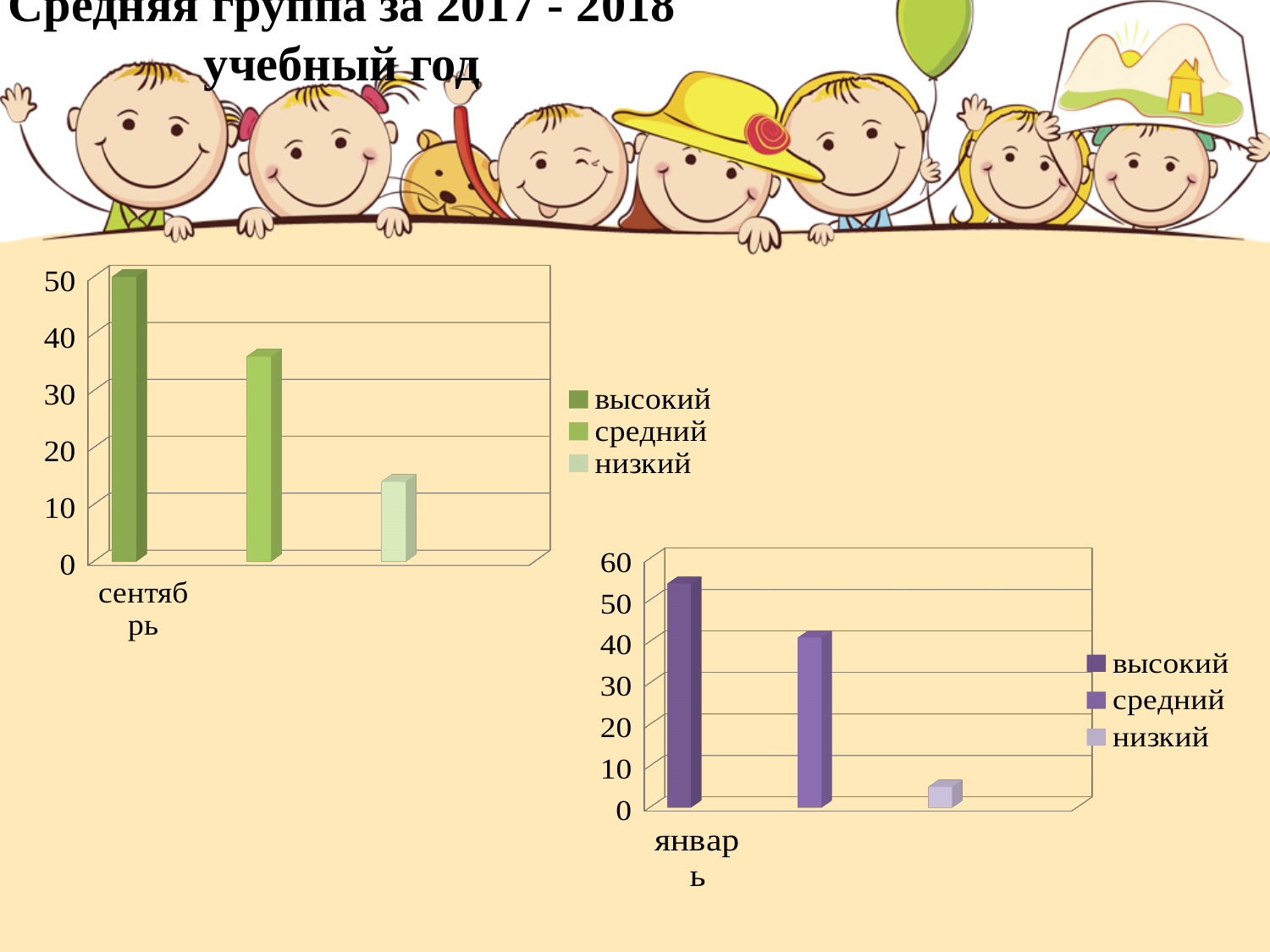
In the right chart (январь), which series has the lowest value? низкий In the left chart (сентябрь), is the value for низкий greater or less than 20? less What kind of chart is the left chart (сентябрь)? bar chart In the right chart (январь), which is larger, the value for средний or the value for низкий? средний In the left chart (сентябрь), is the value for средний greater or less than 30? greater In the right chart (январь), is the value for низкий greater or less than 10? less How many series does the legend of the right chart (январь) list? 3 What category label appears on the x axis of the left chart? сентябрь In the left chart (сентябрь), which series has the highest value? высокий How many bars are plotted in the right chart (январь)? 3 What is the highest tick value on the vertical axis of the right chart (январь)? 60